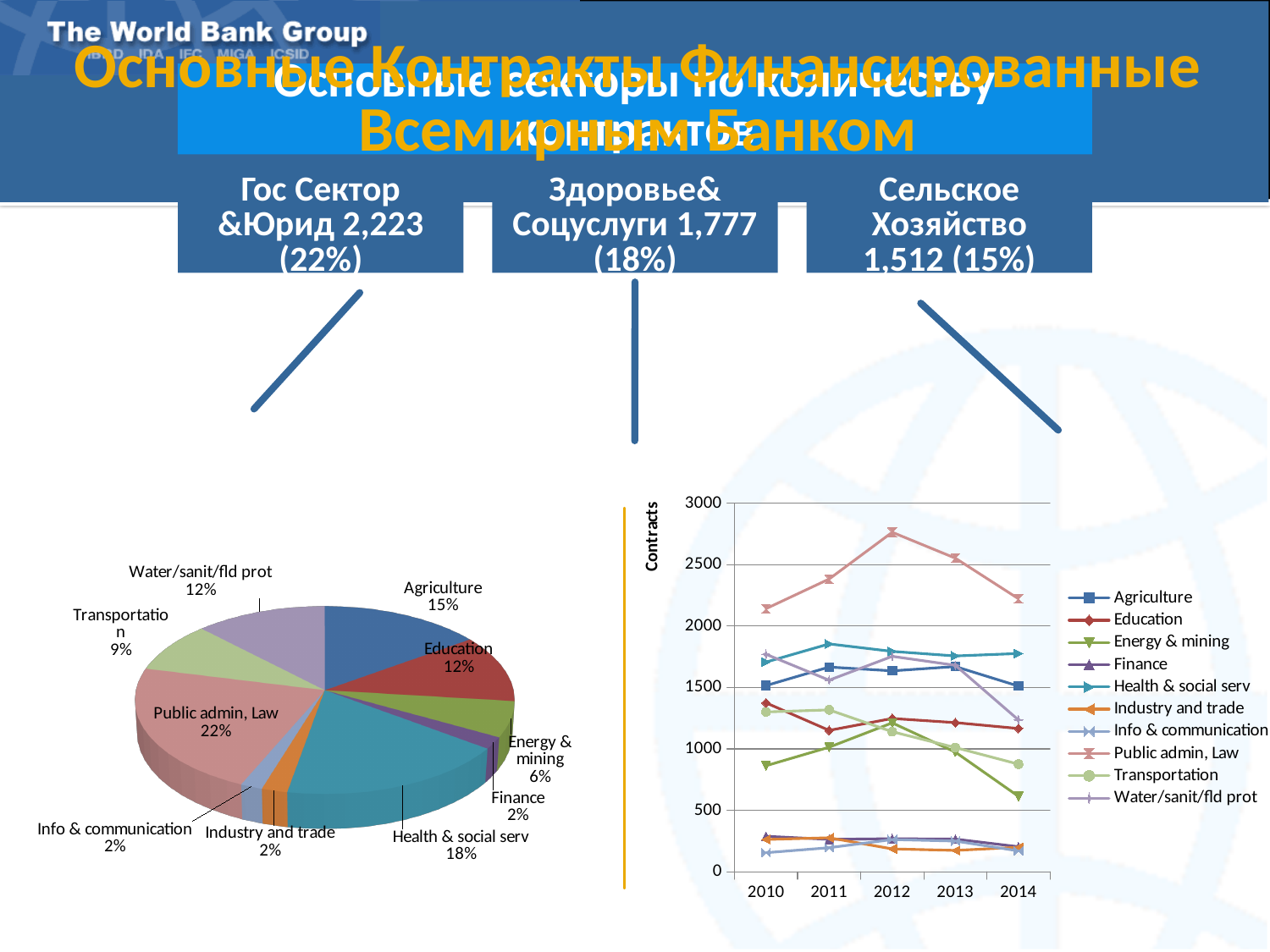
On the pie chart on the left, which has the larger share, Transportation or Water/sanit/fld prot? Water/sanit/fld prot On the pie chart on the left, what share does Public admin, Law have? 22% On the pie chart on the left, how many slices are there? 10 On the line chart on the right, is the value for Public admin, Law in 2012 greater or less than 2500? greater On the line chart on the right, how many series does the legend list? 10 On the line chart on the right, how many years are shown on the x axis? 5 On the pie chart on the left, what is the difference in share between Agriculture and Education? 3% On the pie chart on the left, what share does Health & social serv have? 18% On the line chart on the right, which series has the highest value in 2012? Public admin, Law On the line chart on the right, is the value for Energy & mining in 2014 greater or less than 1000? less What kind of chart is the chart on the right? Line chart On the pie chart on the left, which sector has the largest share? Public admin, Law